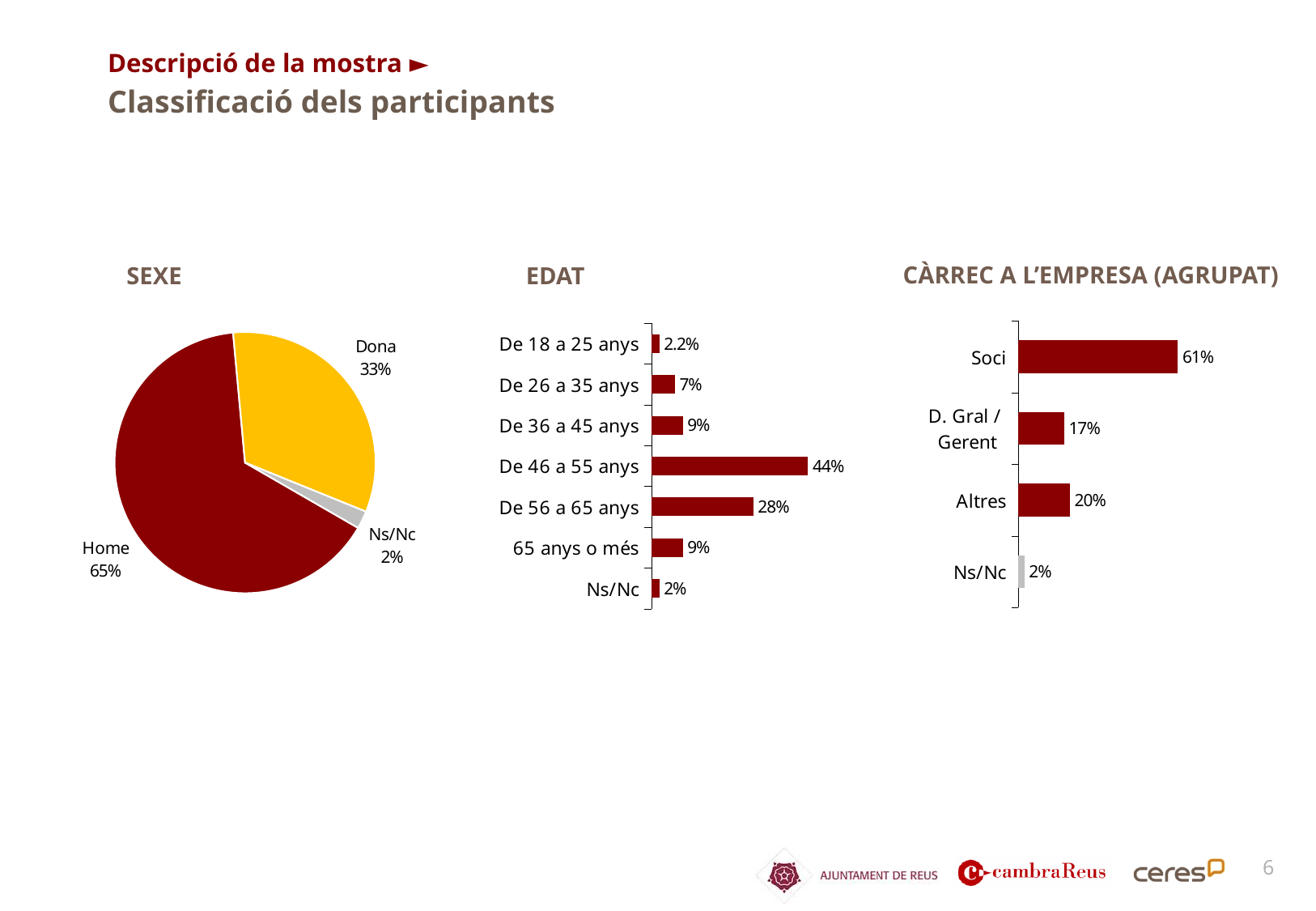
In the EDAT chart, what is the difference between De 46 a 55 anys and De 56 a 65 anys? 16% What kind of chart is the CÀRREC A L'EMPRESA (AGRUPAT) chart? Bar chart In the SEXE chart, what share of participants are Home? 65% In the EDAT chart, how many categories are shown? 7 In the CÀRREC A L'EMPRESA (AGRUPAT) chart, which category has the lowest value? Ns/Nc In the CÀRREC A L'EMPRESA (AGRUPAT) chart, which is larger, D. Gral / Gerent or Altres? Altres In the SEXE chart, what share of participants are Dona? 33% In the EDAT chart, what is the value for De 18 a 25 anys? 2.2% What kind of chart is the SEXE chart? Pie chart In the EDAT chart, what is the value for De 46 a 55 anys? 44% In the EDAT chart, which age group has the highest value? De 46 a 55 anys In the CÀRREC A L'EMPRESA (AGRUPAT) chart, what is the value for Soci? 61%